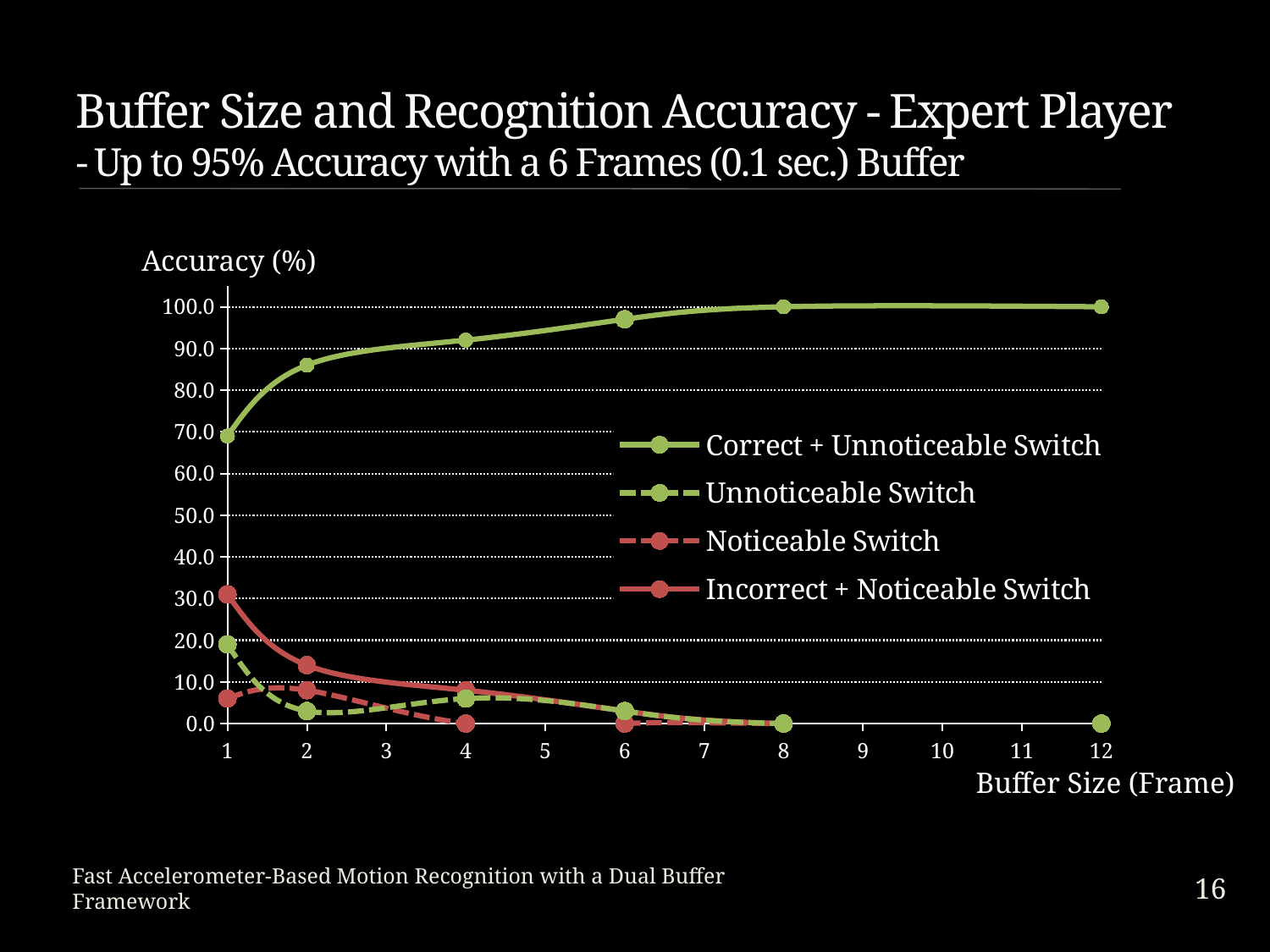
What is the value of the Incorrect + Noticeable Switch series at buffer size 8? 0.0 What is the value of the Correct + Unnoticeable Switch series at buffer size 12? 100.0 What is the value of the Correct + Unnoticeable Switch series at buffer size 8? 100.0 Is the value of the Incorrect + Noticeable Switch series at buffer size 1 greater or less than 20.0? greater What is the label of the x axis? Buffer Size (Frame) How many series does the legend list? 4 At buffer size 1, which is larger: Correct + Unnoticeable Switch or Incorrect + Noticeable Switch? Correct + Unnoticeable Switch What kind of chart is shown on the slide? line chart Does the Correct + Unnoticeable Switch series rise or fall as buffer size increases? rise Does the Incorrect + Noticeable Switch series rise or fall as buffer size increases? fall How many buffer sizes are labelled on the x axis? 12 Is the value of the Correct + Unnoticeable Switch series at buffer size 2 greater or less than 80.0? greater